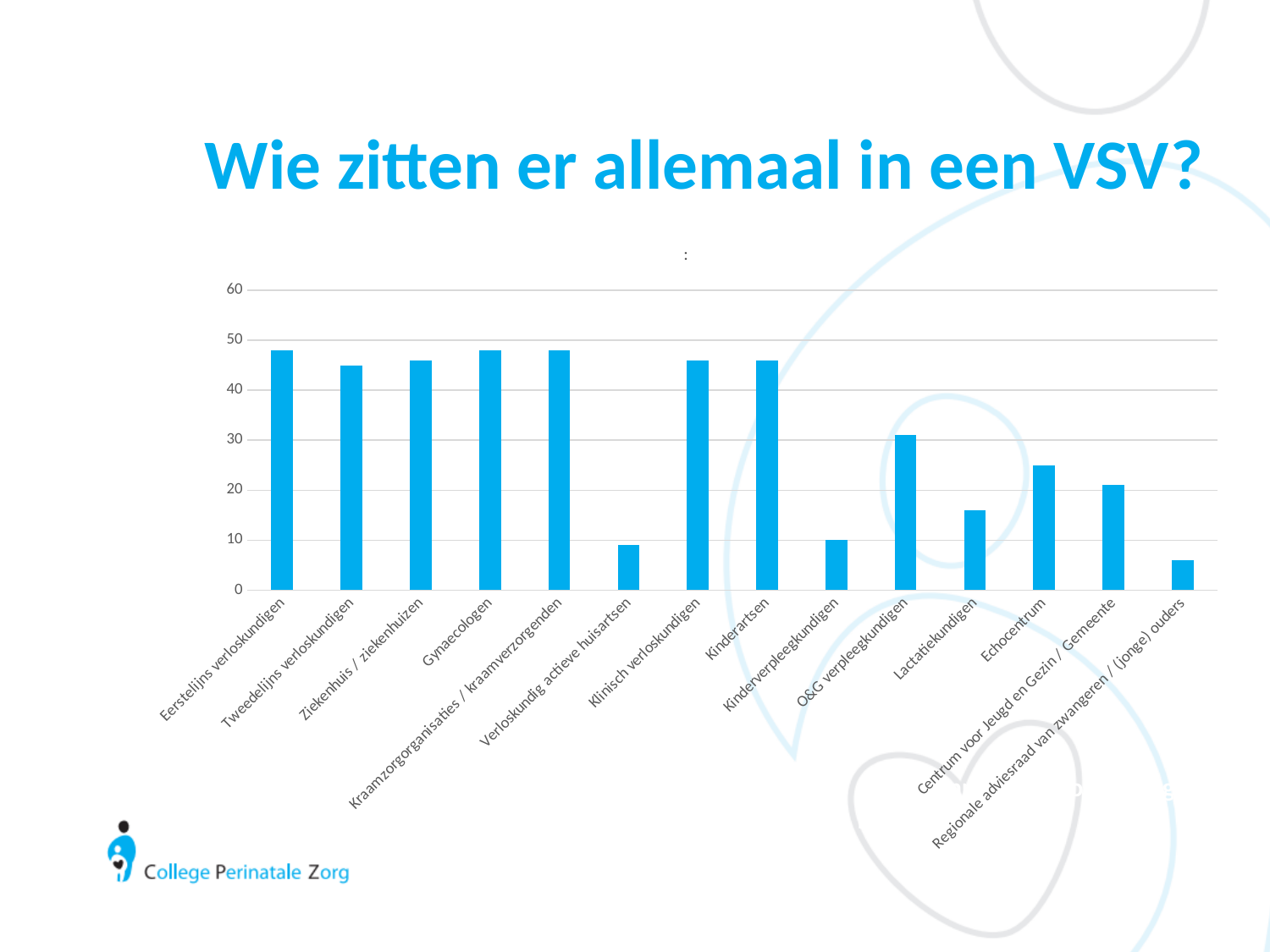
Is the value for Gynaecologen greater or less than 50? less Is the value for Lactatiekundigen greater or less than 20? less Which category has the lowest bar in the chart? Regionale adviesraad van zwangeren / (jonge) ouders What is the title of the slide containing the chart? Wie zitten er allemaal in een VSV? Is the value for Eerstelijns verloskundigen greater or less than 40? greater What kind of chart is shown on the slide? bar chart Which is larger, the value for Echocentrum or the value for Lactatiekundigen? Echocentrum How many categories are shown on the x axis of the chart? 14 Which is larger, the value for Kinderartsen or the value for Kinderverpleegkundigen? Kinderartsen